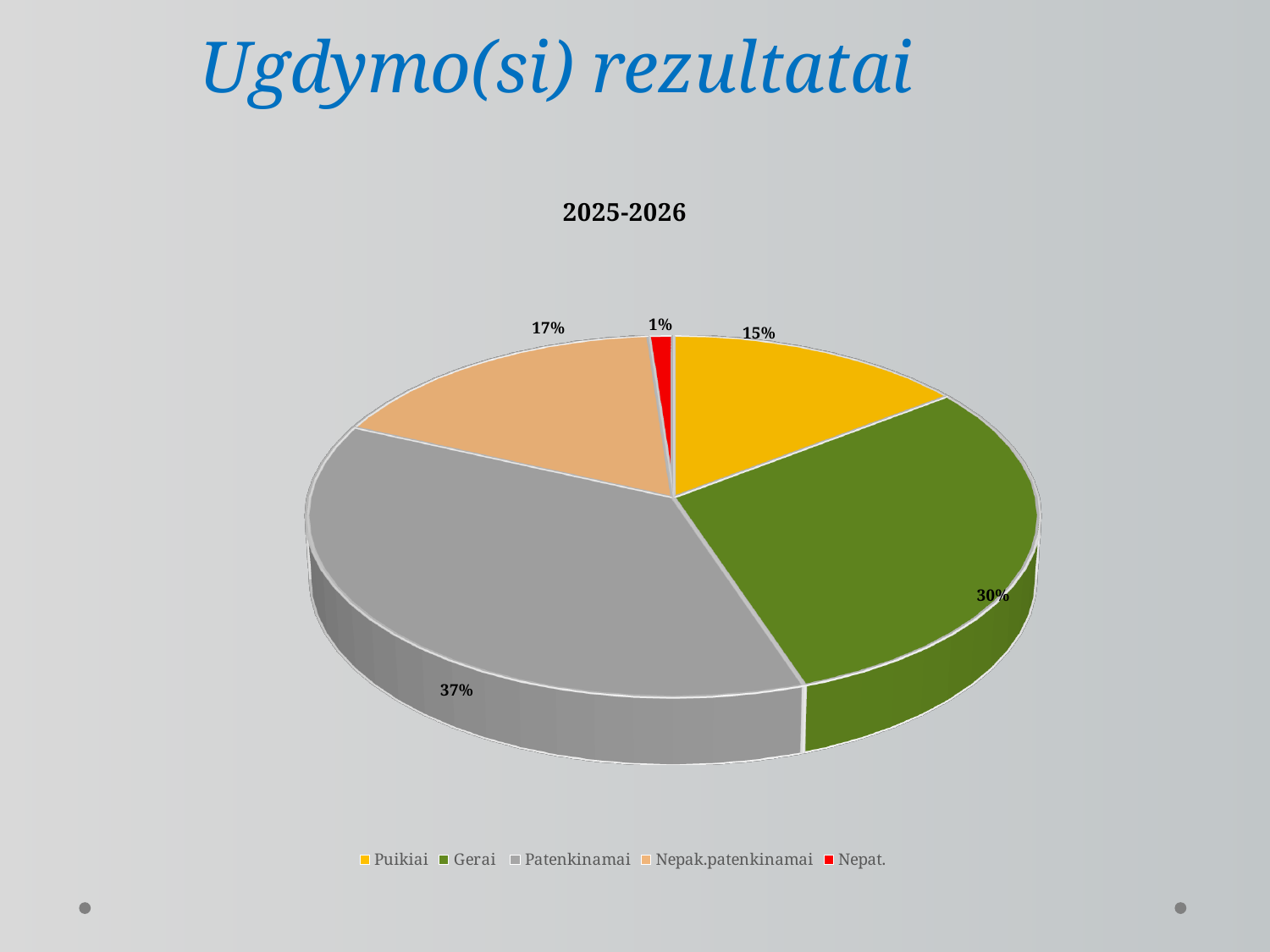
What type of chart is shown on the slide? pie chart What percentage does the Gerai slice show? 30% Which category has the largest share of the pie? Patenkinamai What is the difference in percentage points between the Patenkinamai and Gerai slices? 7 What percentage does the Nepat. slice show? 1% What percentage does the Puikiai slice show? 15% Which is larger, the Puikiai slice or the Nepak.patenkinamai slice? Nepak.patenkinamai What is the chart's title? 2025-2026 How many categories does the legend list? 5 What percentage does the Patenkinamai slice show? 37% What percentage does the Nepak.patenkinamai slice show? 17% Which category has the smallest share of the pie? Nepat.